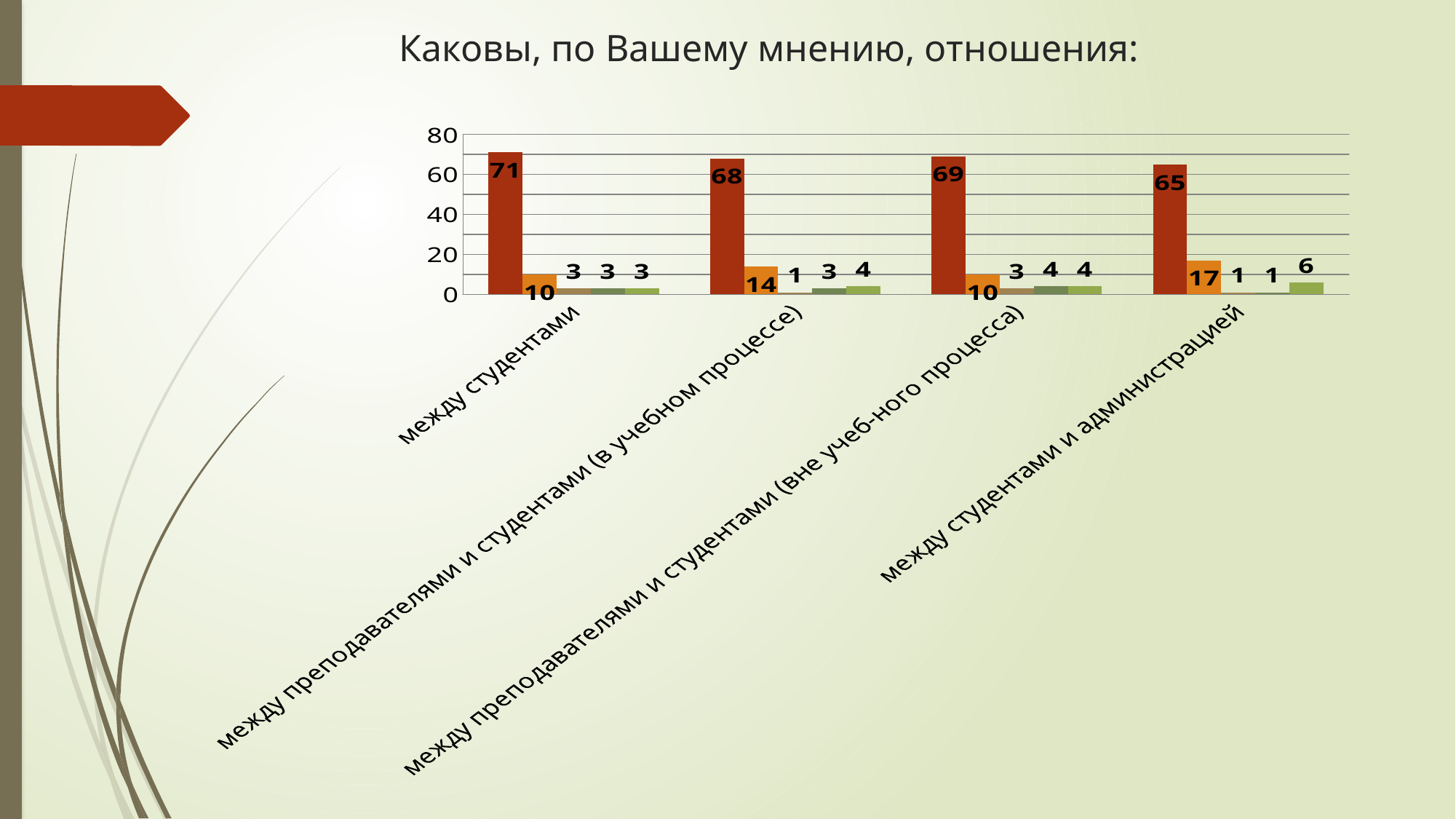
What is the value of the orange bar for 'между преподавателями и студентами (в учебном процессе)'? 14 Which category has the lowest dark red bar? между студентами и администрацией What kind of chart is shown on the slide? bar chart What is the value of the dark red bar for 'между студентами и администрацией'? 65 How many categories are shown on the x axis of the chart? 4 Which category has the highest dark red bar? между студентами What is the title of the slide above the chart? Каковы, по Вашему мнению, отношения: What is the value of the orange bar for 'между студентами и администрацией'? 17 Is the dark red bar for 'между преподавателями и студентами (вне учеб-ного процесса)' greater or less than 60? greater What is the difference between the dark red bar values for 'между студентами' and 'между студентами и администрацией'? 6 Which is larger: the orange bar for 'между студентами' or the orange bar for 'между студентами и администрацией'? между студентами и администрацией What is the value of the tallest (dark red) bar for the category 'между студентами'? 71